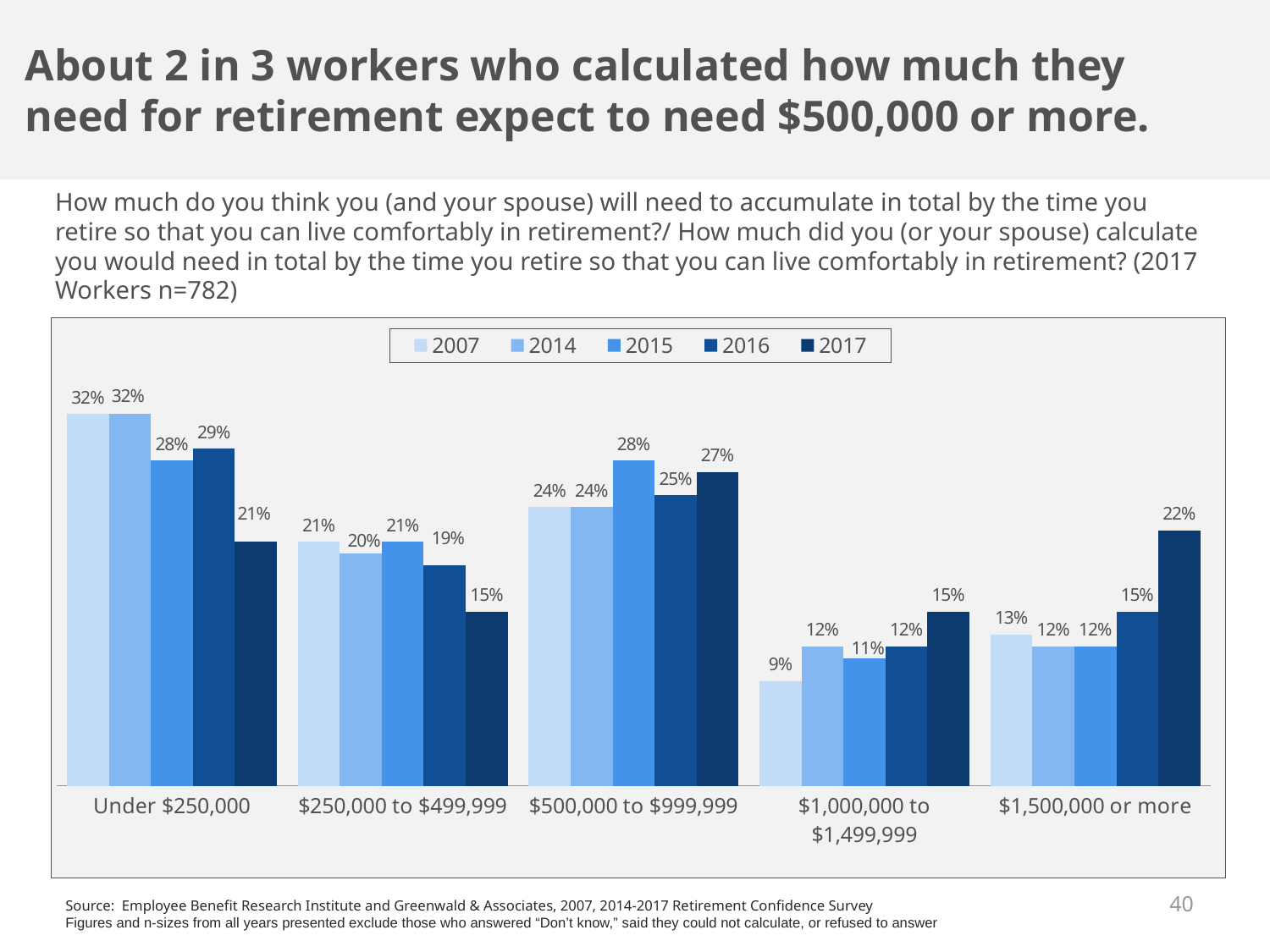
How many series does the legend list? 5 What percentage of workers in 2017 expect to need $1,500,000 or more for retirement? 22% What is the value for 2015 in the "$500,000 to $999,999" category? 28% What is the value for 2007 in the "Under $250,000" category? 32% What is the value for 2007 in the "$1,000,000 to $1,499,999" category? 9% Which category has the lowest value for 2007? $1,000,000 to $1,499,999 Which years are listed in the chart legend? 2007, 2014, 2015, 2016, 2017 Which category has the highest value for 2017? $500,000 to $999,999 How many categories are shown on the x axis? 5 In the "$1,500,000 or more" category, which year has the larger value, 2016 or 2017? 2017 What kind of chart is shown on the slide? Bar chart What is the difference between the 2007 and 2017 values in the "Under $250,000" category? 11 percentage points